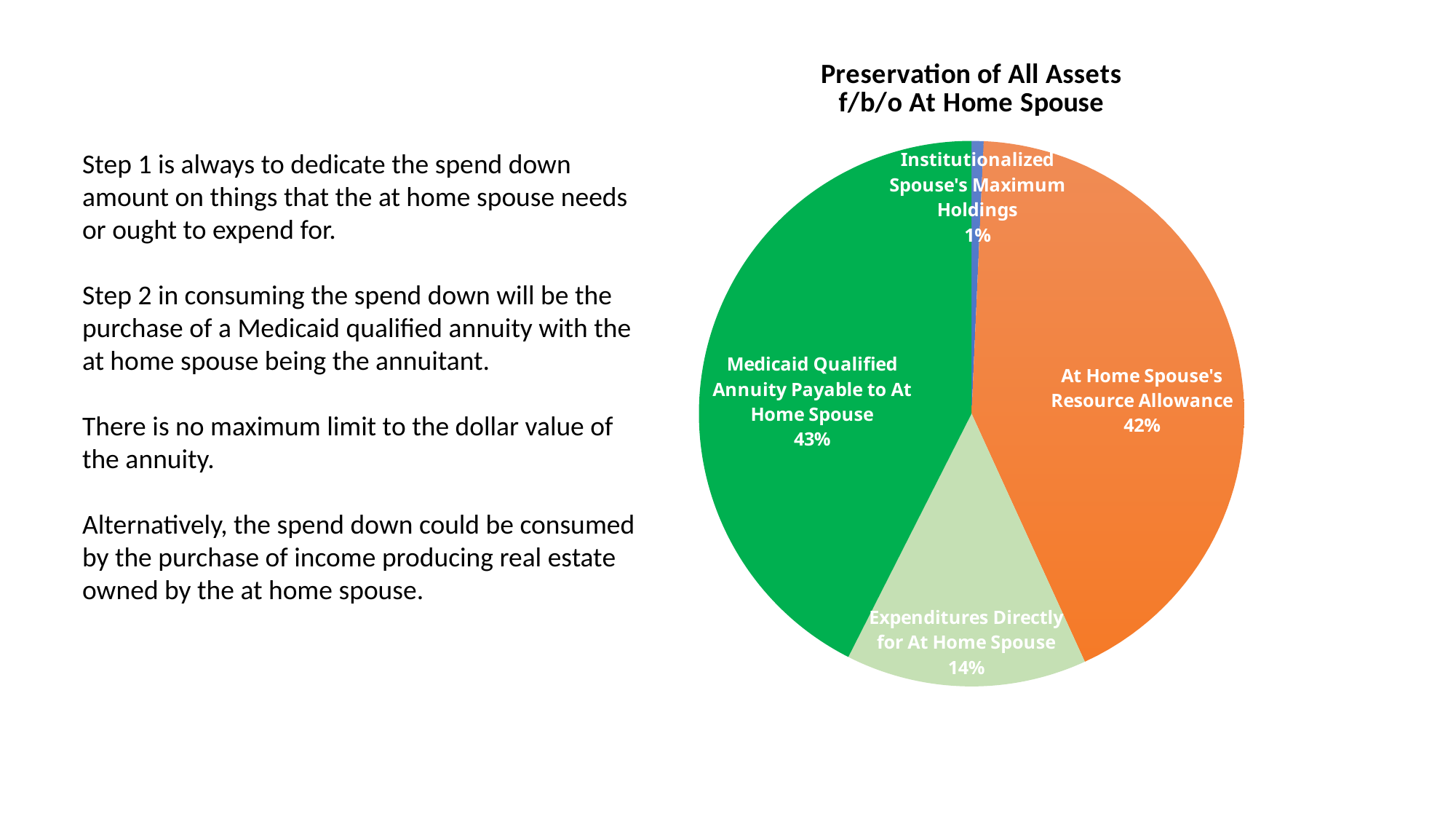
What share of the pie is Medicaid Qualified Annuity Payable to At Home Spouse? 43% How many slices does the pie chart have? 4 What type of chart is shown on the slide? pie chart What share of the pie is At Home Spouse's Resource Allowance? 42% What share of the pie is Institutionalized Spouse's Maximum Holdings? 1% Which is larger: Expenditures Directly for At Home Spouse or At Home Spouse's Resource Allowance? At Home Spouse's Resource Allowance Which slice of the pie is the smallest? Institutionalized Spouse's Maximum Holdings What colour is the Expenditures Directly for At Home Spouse slice? light green What is the difference in percentage points between Medicaid Qualified Annuity Payable to At Home Spouse and Expenditures Directly for At Home Spouse? 29 What is the title of the chart? Preservation of All Assets f/b/o At Home Spouse What is the difference in percentage points between At Home Spouse's Resource Allowance and Institutionalized Spouse's Maximum Holdings? 41